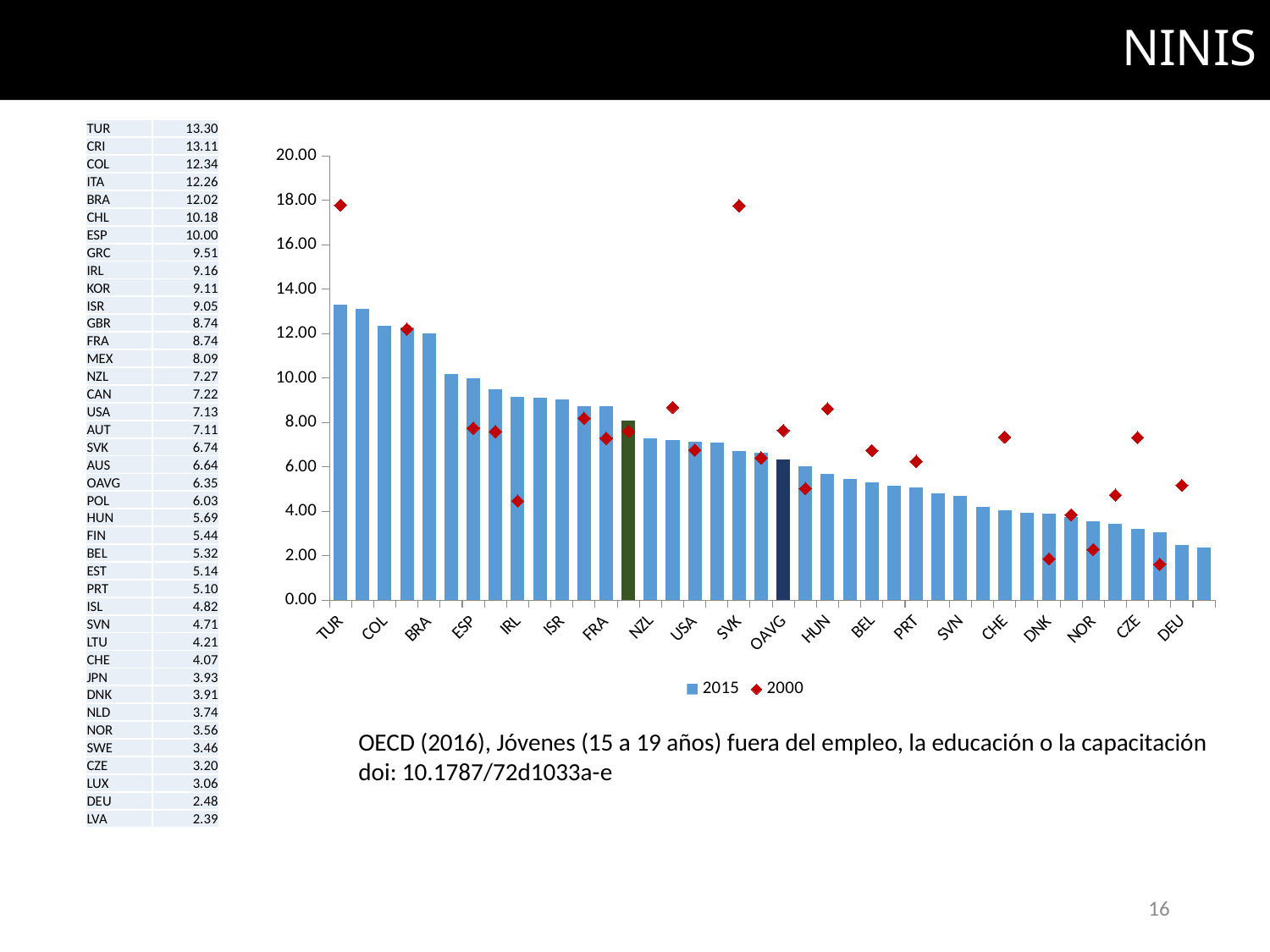
Which has the larger 2015 value, ESP or IRL? ESP Is the 2000 value for IRL greater or less than 6.00? less What is the 2015 value for OAVG? 6.35 What is the 2015 value for TUR? 13.30 How many series does the legend list? 2 Which country has the highest 2015 value? TUR What is the difference between the 2015 values for ESP and OAVG? 3.65 Do the 2015 bars rise or fall from left to right along the x axis? fall What is the 2015 value for DEU? 2.48 What kind of chart is shown on the slide? bar chart What is the difference between the 2015 values for TUR and CRI? 0.19 Is the 2000 value for TUR greater or less than 16.00? greater